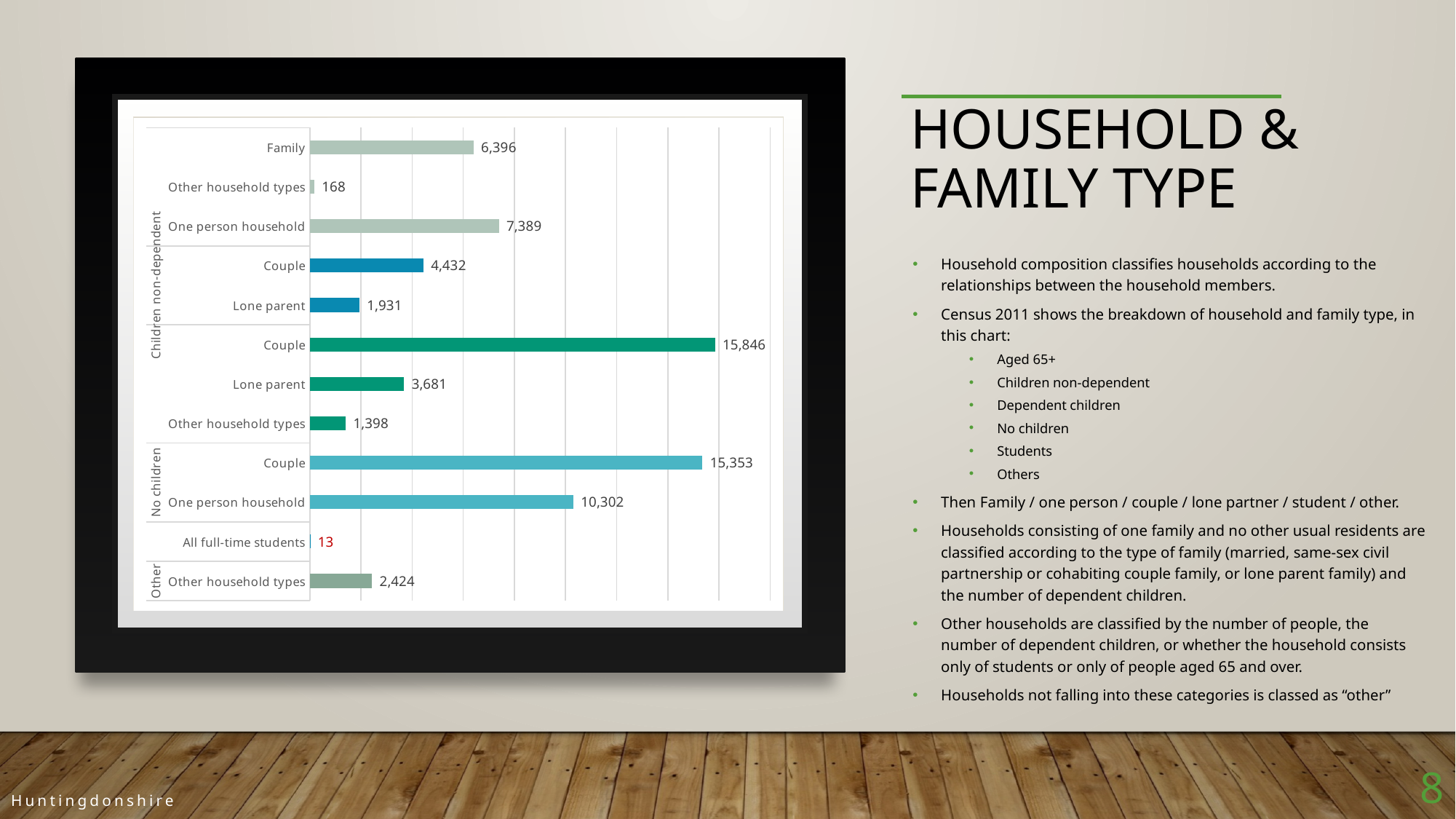
What type of chart is shown on the slide? Bar chart Which One person household bar is larger: the one near the top of the chart or the one in the No children group? The one in the No children group (10,302) How many bars are plotted on the chart? 12 What is the difference between the blue Couple bar (4,432) and the blue Lone parent bar (1,931)? 2,501 What is the value of the One person household bar in the No children group? 10,302 What is the value of the Family bar? 6,396 What is the value shown for All full-time students? 13 Which bar has the highest value on the chart? Couple (15,846) Which bar has the lowest value on the chart? All full-time students (13) What is the difference between the largest Couple bar (15,846) and the Couple bar in the No children group (15,353)? 493 What is the value of the Other household types bar in the Other group at the bottom of the chart? 2,424 What is the value of the dark green Lone parent bar? 3,681